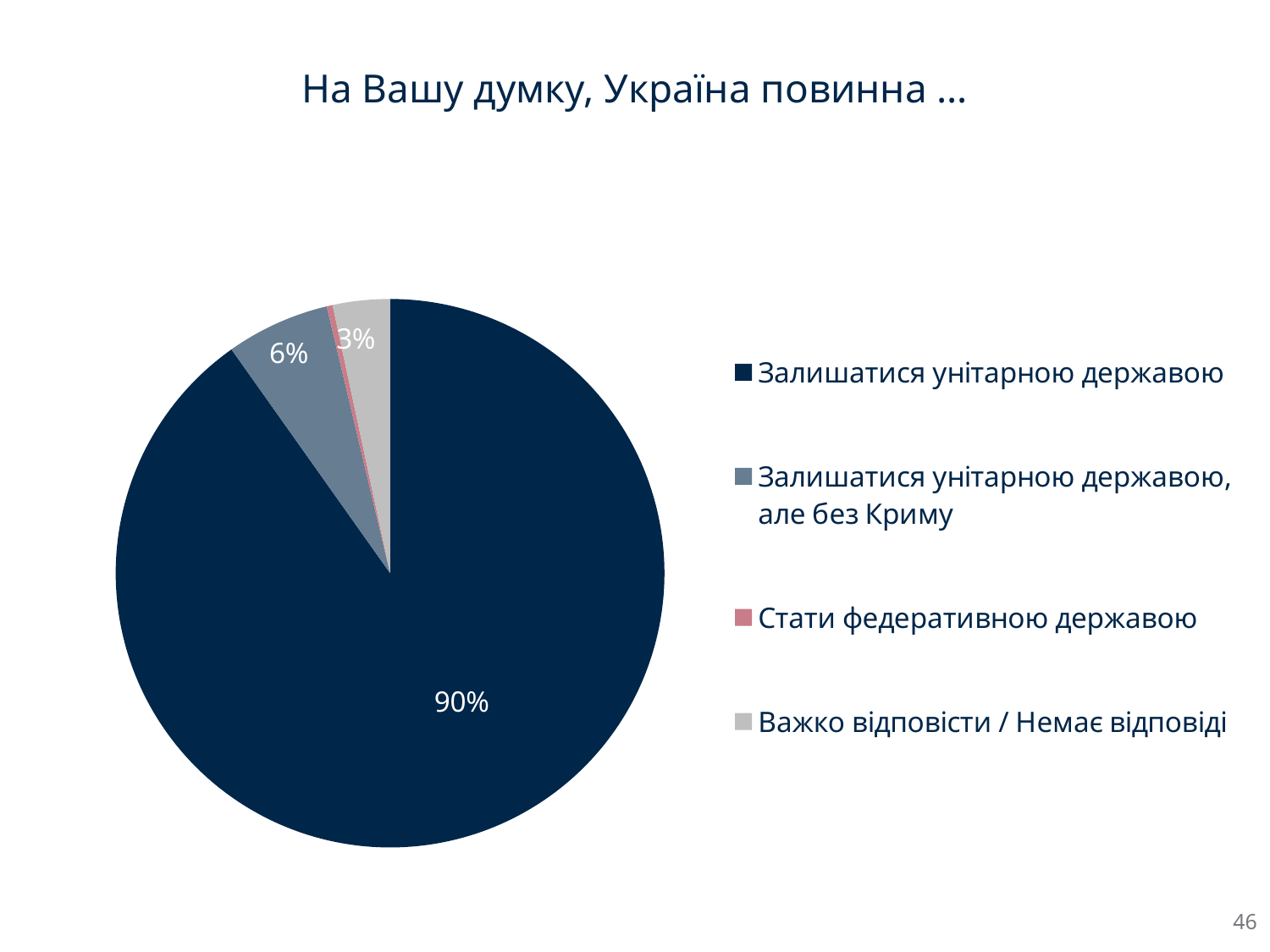
Which category has the smallest slice of the pie? Стати федеративною державою What share of the pie is labelled for "Залишатися унітарною державою"? 90% What kind of chart is shown on the slide? pie chart What is the difference between the shares for "Залишатися унітарною державою" and "Залишатися унітарною державою, але без Криму"? 84% What share of the pie is labelled for "Залишатися унітарною державою, але без Криму"? 6% How many categories does the legend of the pie chart list? 4 What share of the pie is labelled for "Важко відповісти / Немає відповіді"? 3% Which is larger: the slice for "Залишатися унітарною державою, але без Криму" or the slice for "Важко відповісти / Немає відповіді"? Залишатися унітарною державою, але без Криму What colour is the slice for "Стати федеративною державою" in the legend? pink What is the difference between the shares for "Залишатися унітарною державою, але без Криму" and "Важко відповісти / Немає відповіді"? 3% What is the title of the chart? На Вашу думку, Україна повинна ... Which category has the largest slice of the pie? Залишатися унітарною державою